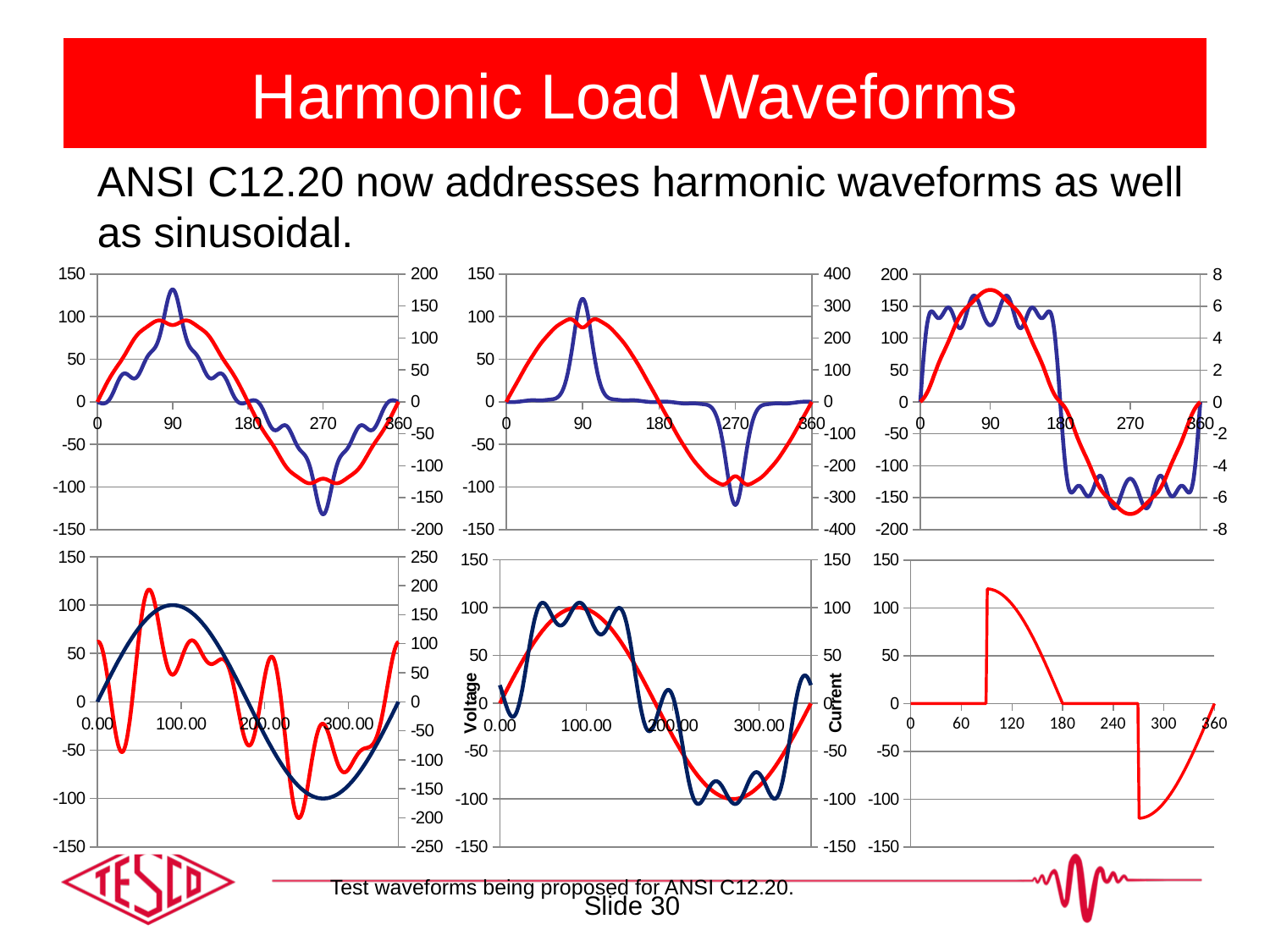
In the bottom-right chart, what is the value of the red line at x = 240? 0 What kind of chart is the top-left chart on the slide? line chart How many tick labels are shown on the horizontal axis of the bottom-right chart? 7 In the bottom-right chart, is the maximum value of the red line greater or less than 100? greater In the top-left chart, does the red line rise or fall between x = 0 and x = 90? rise In the bottom-right chart, what is the value of the red line at x = 60? 0 In the top-right chart, what is the highest value shown on the right-hand vertical axis? 8 In the bottom-right chart, is the minimum value of the red line greater or less than -100? less In the top-left chart, is the value of the red line at x = 90 (left axis) greater or less than 50? greater In the bottom-right chart, does the red line rise or fall between x = 120 and x = 180? fall In the bottom-middle chart, what is the title of the left vertical axis? Voltage How many charts are shown on the slide? 6